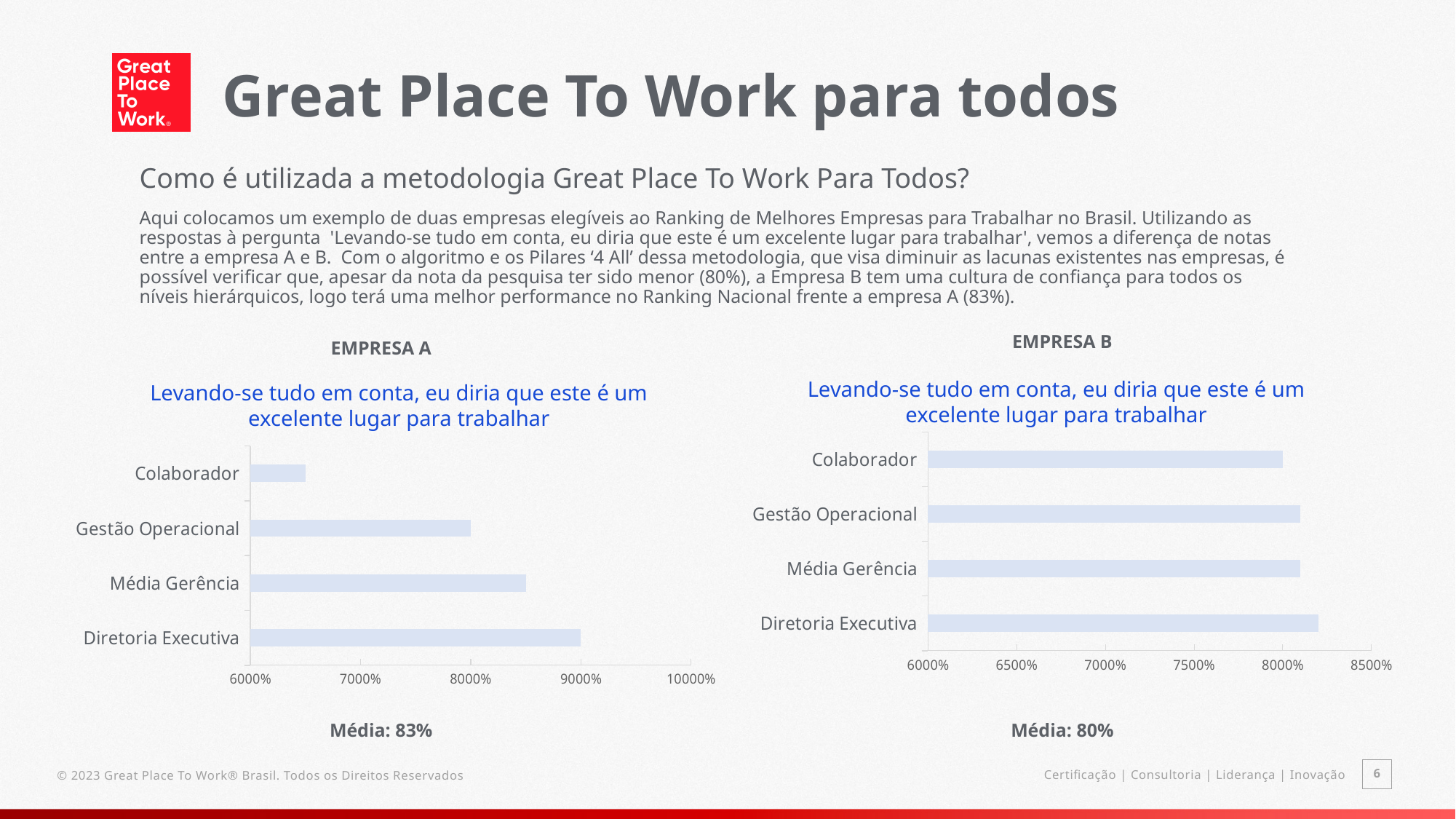
In the Empresa A chart, which is larger, the value for Média Gerência or the value for Gestão Operacional? Média Gerência In the Empresa A chart, which category has the lowest value? Colaborador What kind of chart is the Empresa A chart? bar chart In the Empresa B chart, which category has the lowest value? Colaborador How many categories are shown in the Empresa B chart? 4 In the Empresa A chart, is the value for Média Gerência greater or less than 8000%? greater In the Empresa B chart, is the value for Diretoria Executiva greater or less than 8000%? greater In the Empresa B chart, which category has the highest value? Diretoria Executiva What is the Média (average) shown below the Empresa B chart? 80% In the Empresa B chart, which is larger, the value for Diretoria Executiva or the value for Colaborador? Diretoria Executiva In the Empresa A chart, which category has the highest value? Diretoria Executiva In the Empresa A chart, is the value for Colaborador greater or less than 7000%? less